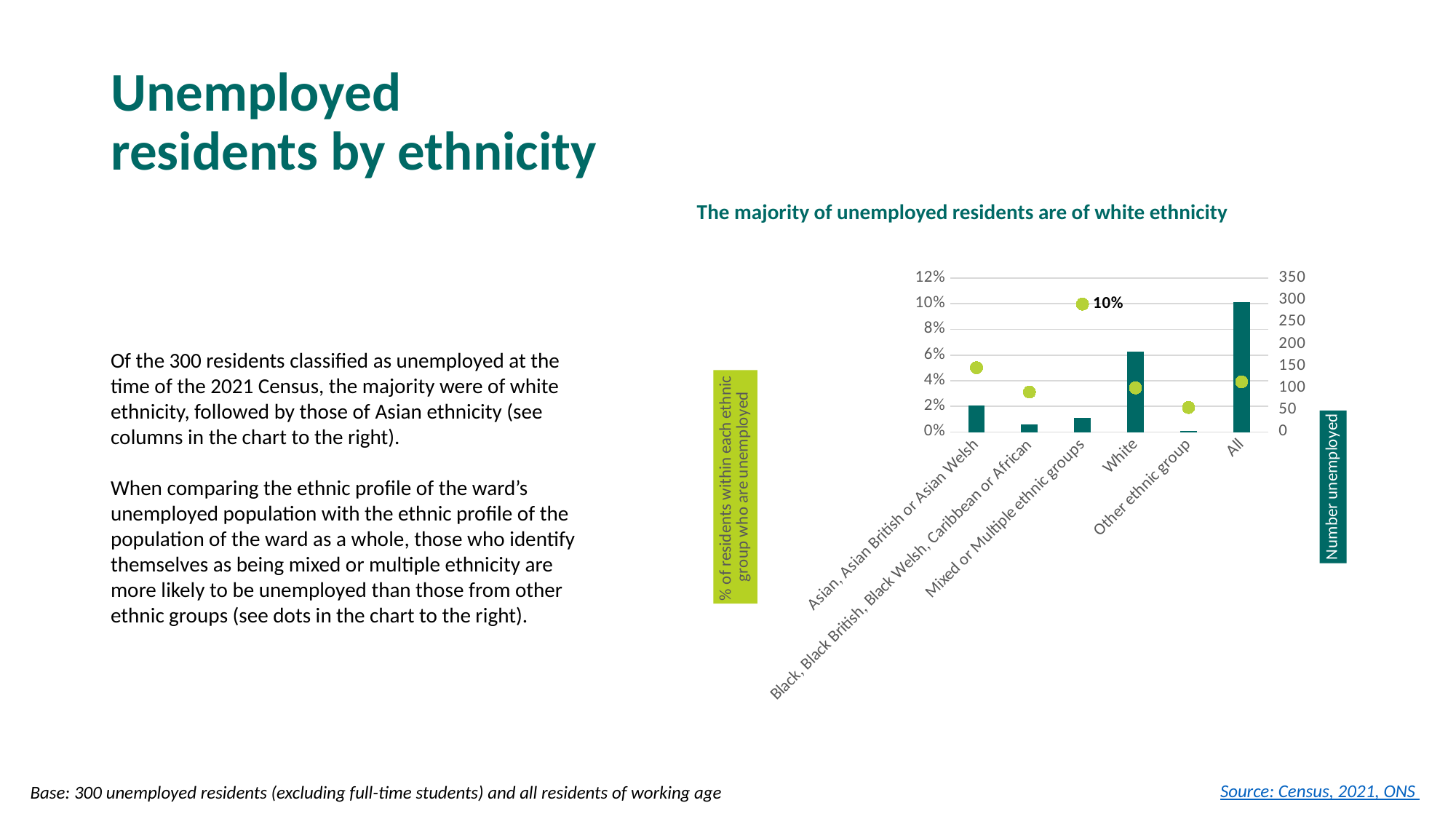
What does the right-hand vertical axis of the chart measure? Number unemployed Is the number unemployed bar for Black, Black British, Black Welsh, Caribbean or African greater or less than 50? less Which has a higher percentage of residents unemployed: Asian, Asian British or Asian Welsh, or Other ethnic group? Asian, Asian British or Asian Welsh Excluding the 'All' bar, which ethnic group has the tallest bar for number unemployed? White Is the number unemployed bar for All greater or less than 250? greater What is the title of the chart? The majority of unemployed residents are of white ethnicity Which category has the shortest bar for number unemployed? Other ethnic group How many categories are shown on the x axis of the chart? 6 What is the data label shown on the dot for Mixed or Multiple ethnic groups? 10% Is the number unemployed bar for White greater or less than 150? greater Which category has the lowest percentage of residents who are unemployed (the dots)? Other ethnic group Which category has the highest percentage of residents who are unemployed (the dots)? Mixed or Multiple ethnic groups